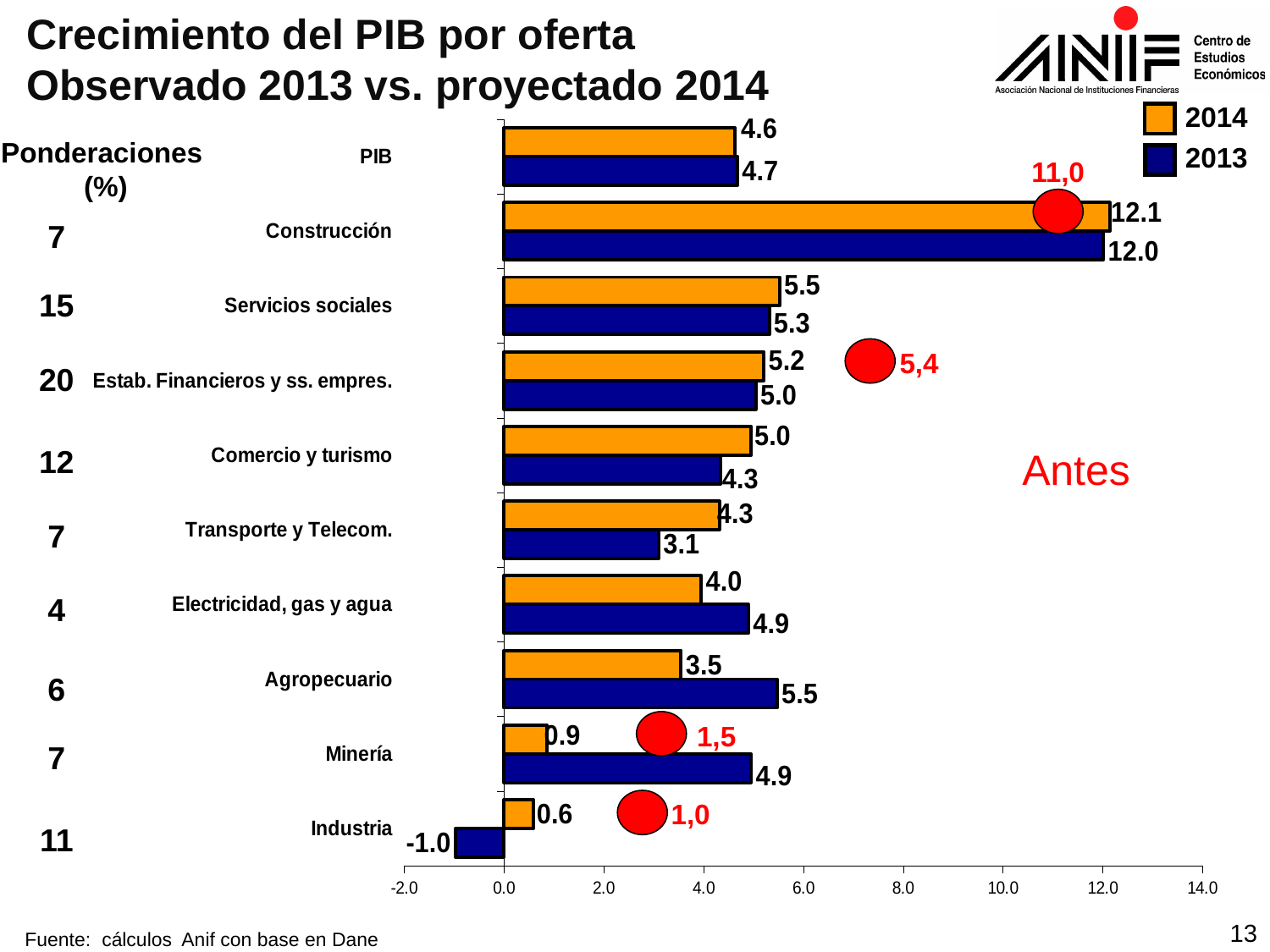
Which category has the highest 2014 value? Construcción What is the 2013 value for Transporte y Telecom.? 3.1 How many categories are plotted on the chart? 10 What is the difference between the 2014 and 2013 values for Comercio y turismo? 0.7 What is the difference between the 2013 and 2014 values for Minería? 4.0 What is the 2014 value for Construcción? 12.1 Which colour represents the 2014 series in the legend? orange For Agropecuario, which is larger: the 2014 value or the 2013 value? 2013 Which category has the lowest 2013 value? Industria How many series does the legend list? 2 What is the 2013 value for Industria? -1.0 What kind of chart is shown on the slide? bar chart